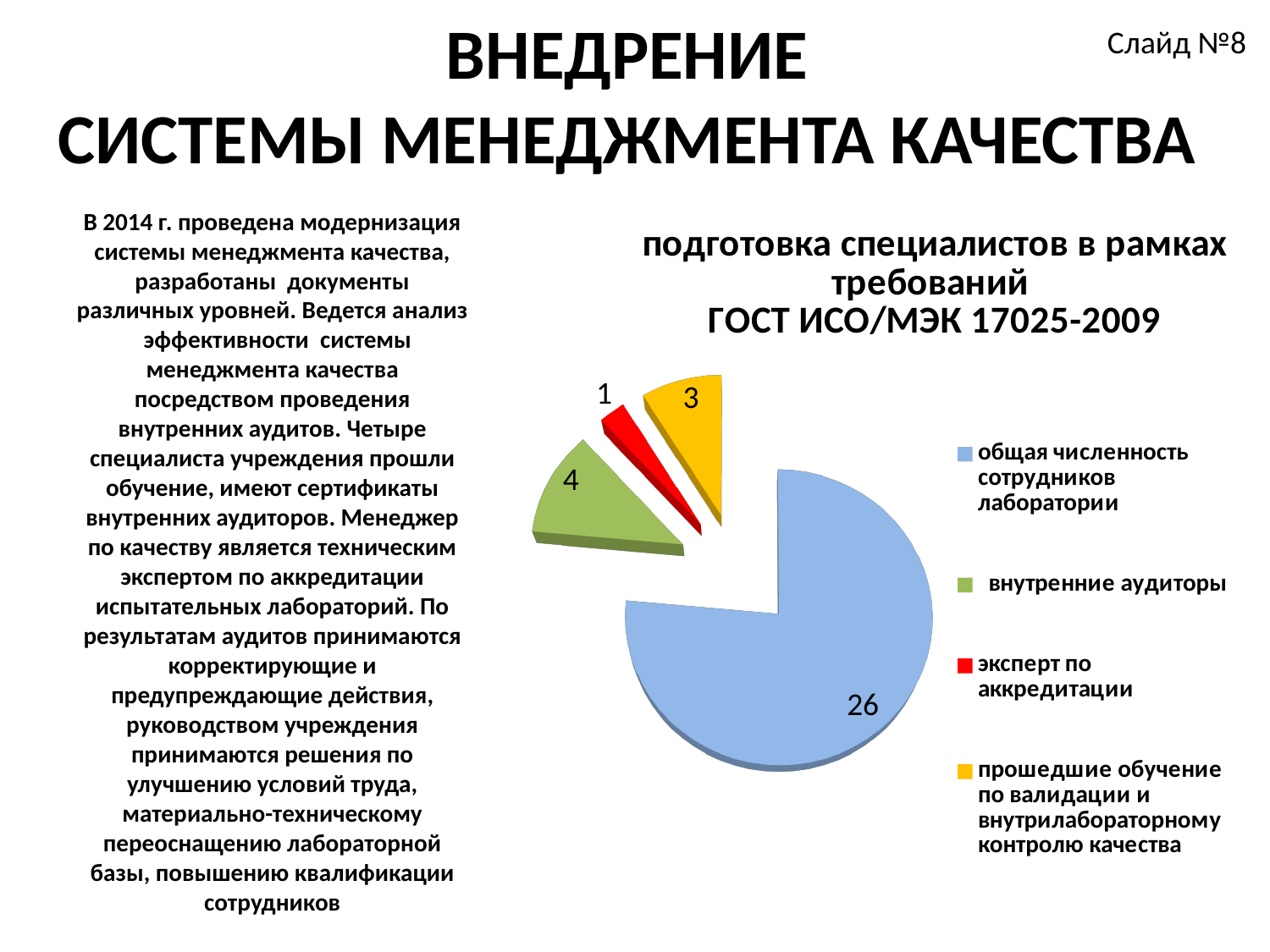
What is the value for "общая численность сотрудников лаборатории"? 26 What is the value for "прошедшие обучение по валидации и внутрилабораторному контролю качества"? 3 Which category has the largest slice of the pie? общая численность сотрудников лаборатории What is the difference between the value for "внутренние аудиторы" and the value for "эксперт по аккредитации"? 3 What is the value for "внутренние аудиторы"? 4 What is the total of all the values shown in the pie chart? 34 Which category has the smallest slice of the pie? эксперт по аккредитации What colour is the slice for "эксперт по аккредитации"? Red How many slices does the pie chart have? 4 What is the value for "эксперт по аккредитации"? 1 Which is larger: the value for "внутренние аудиторы" or the value for "прошедшие обучение по валидации и внутрилабораторному контролю качества"? внутренние аудиторы What type of chart is shown on the slide? Pie chart